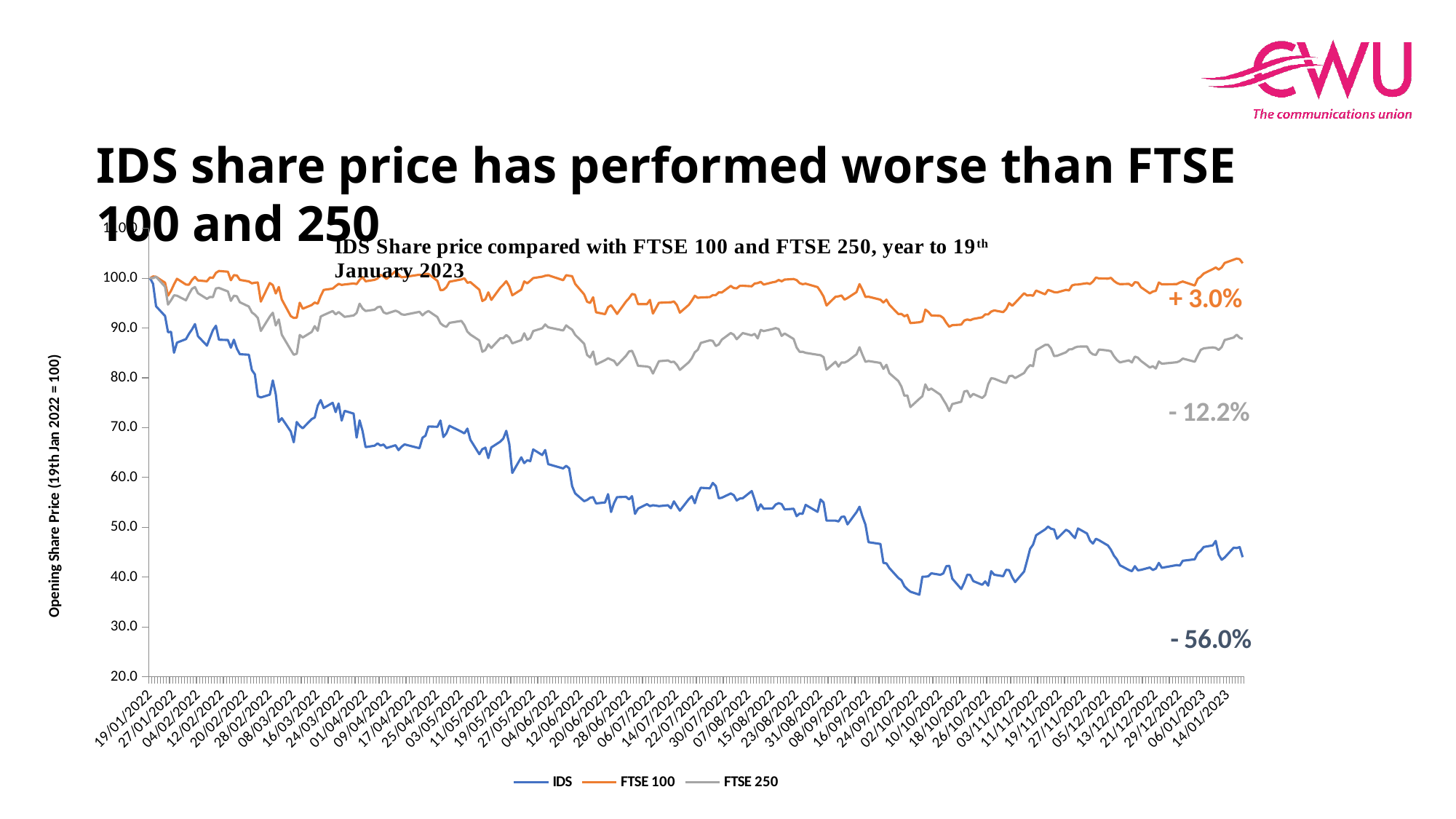
What percentage change is labelled for the FTSE 100 line at the end of the period? + 3.0% Which series has the highest value at the end of the period (January 2023)? FTSE 100 What percentage change is labelled for the FTSE 250 line at the end of the period? - 12.2% Does the IDS line rise or fall overall from 19/01/2022 to 14/01/2023? Fall By how many percentage points does the labelled change for FTSE 250 (- 12.2%) differ from that for IDS (- 56.0%)? 43.8 percentage points What is the label on the vertical axis of the chart? Opening Share Price (19th Jan 2022 = 100) Is the value of the IDS line at the end of the period greater or less than 50.0? less What kind of chart is shown on the slide? Line chart How many series does the chart legend list? 3 Which series are listed in the chart legend? IDS, FTSE 100, FTSE 250 Which series has the lowest value at the end of the period (January 2023)? IDS What percentage change is labelled for the IDS line at the end of the period? - 56.0%